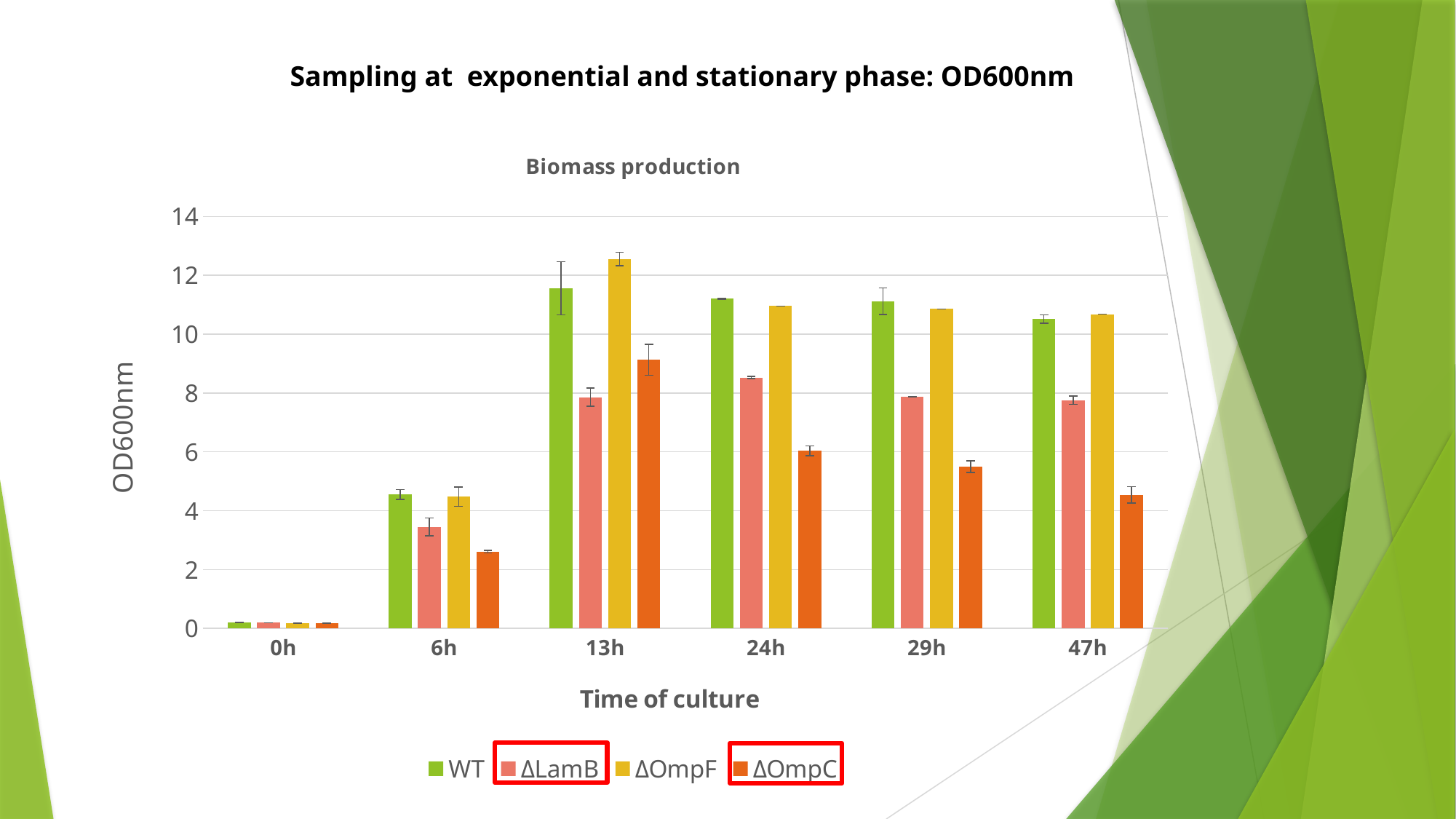
At 13h, which is larger: ΔOmpC or ΔLamB? ΔOmpC What kind of chart is shown on the slide? bar chart Is the value for ΔOmpF at 13h greater or less than 12? greater Which series has the lowest value at 47h? ΔOmpC Is the value for ΔLamB at 6h greater or less than 4? less Do the values for ΔOmpC rise or fall from 13h to 47h? fall Which series has the highest value at 13h? ΔOmpF For WT, which is larger: the value at 13h or at 47h? 13h Is the value for ΔOmpC at 47h greater or less than 6? less What is the label on the y axis of the chart? OD600nm How many time points are shown on the x axis? 6 How many series does the legend list? 4